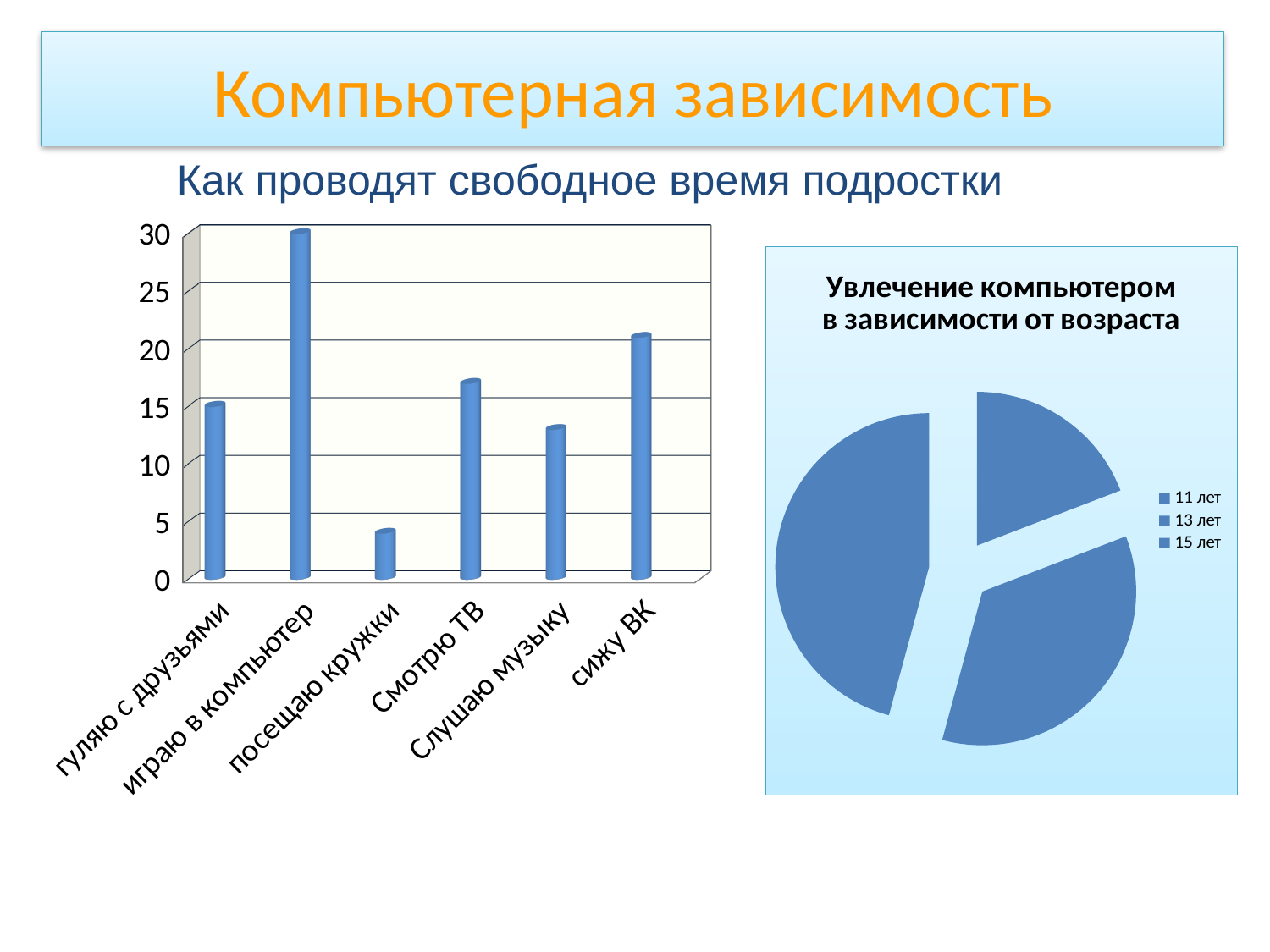
In the left bar chart 'Как проводят свободное время подростки', which is larger: 'сижу ВК' or 'гуляю с друзьями'? сижу ВК In the left bar chart 'Как проводят свободное время подростки', which is larger: 'Смотрю ТВ' or 'Слушаю музыку'? Смотрю ТВ What kind of chart is the right chart, 'Увлечение компьютером в зависимости от возраста'? pie chart In the left bar chart 'Как проводят свободное время подростки', how many categories are shown on the x axis? 6 In the left bar chart 'Как проводят свободное время подростки', which category has the lowest value? посещаю кружки In the right pie chart 'Увлечение компьютером в зависимости от возраста', how many entries does the legend list? 3 In the left bar chart 'Как проводят свободное время подростки', is the value for 'сижу ВК' greater or less than 15? greater In the left bar chart 'Как проводят свободное время подростки', is the value for 'Слушаю музыку' greater or less than 10? greater What kind of chart is the left chart, 'Как проводят свободное время подростки'? bar chart In the left bar chart 'Как проводят свободное время подростки', which category has the highest value? играю в компьютер In the left bar chart 'Как проводят свободное время подростки', is the value for 'играю в компьютер' greater or less than 25? greater